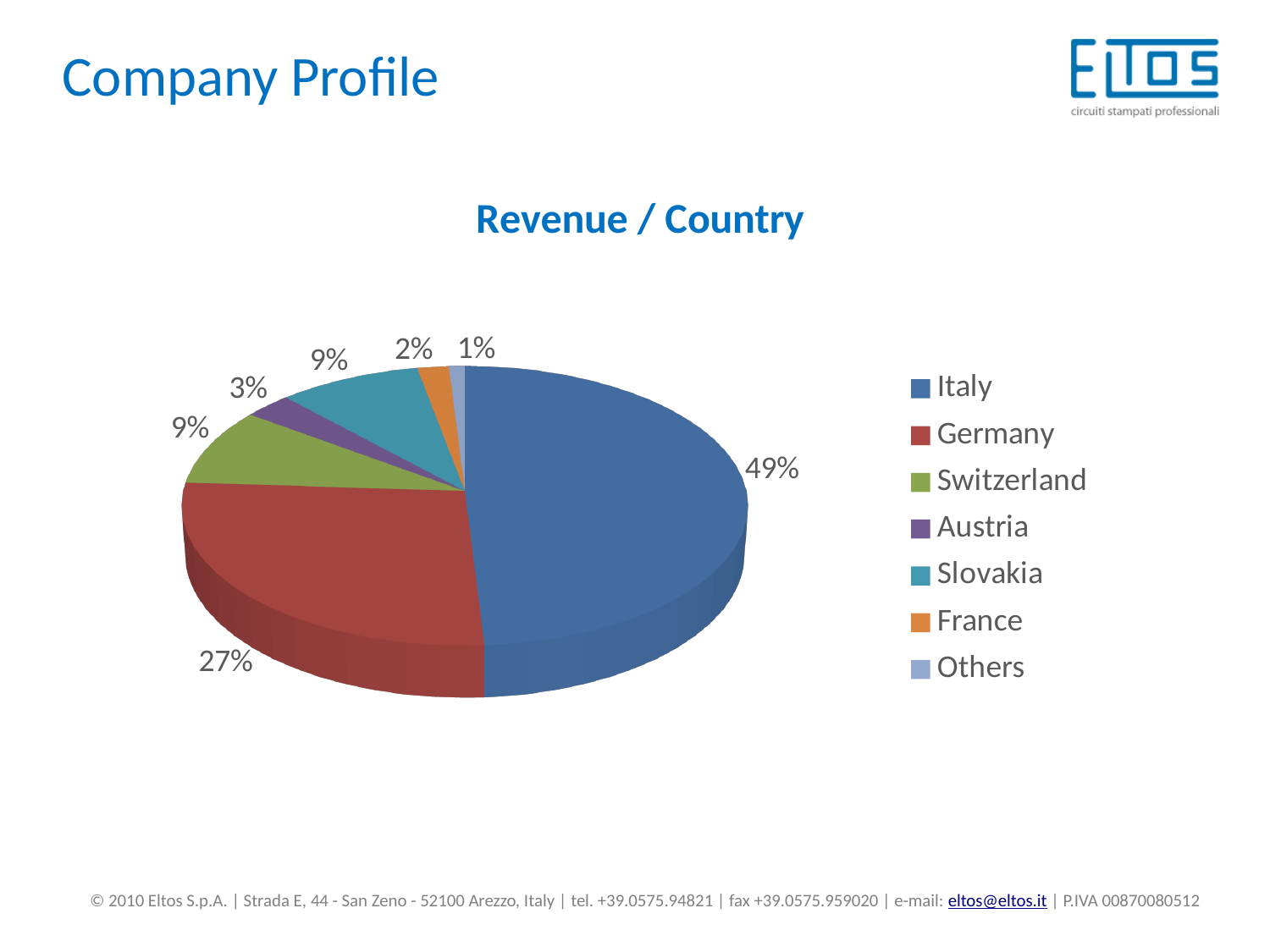
Which country has the largest share of revenue? Italy How many categories does the legend list? 7 Which category has the smallest share of revenue? Others What share of revenue comes from Others? 1% What is the title of the chart? Revenue / Country What share of revenue comes from Germany? 27% What share of revenue comes from Austria? 3% What type of chart is shown on the slide? Pie chart Which has a larger share of revenue, Austria or France? Austria What is the difference in percentage points between Italy's and Germany's shares? 22